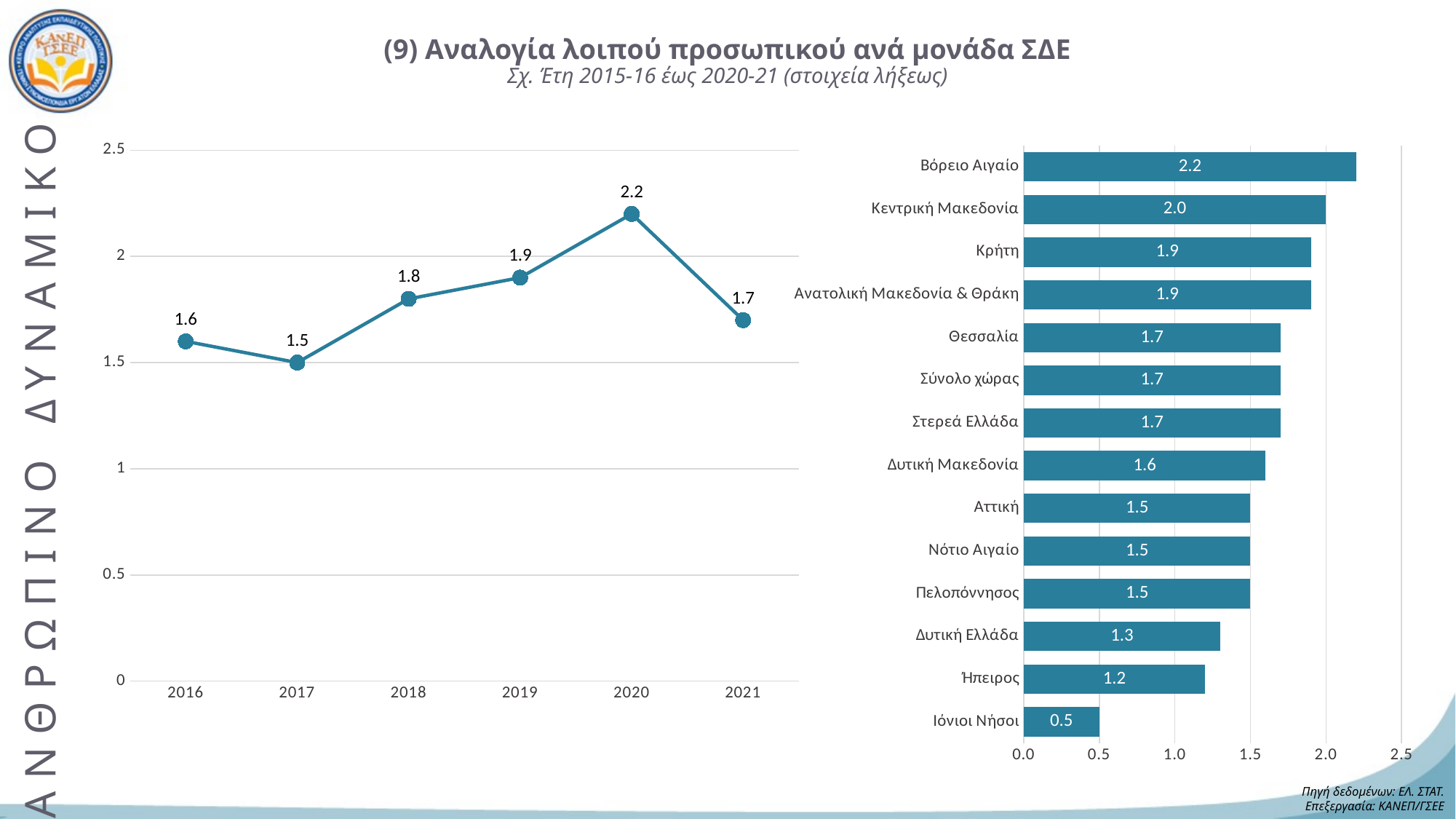
In the bar chart on the right, which is larger, the value for Κεντρική Μακεδονία or the value for Ήπειρος? Κεντρική Μακεδονία In the bar chart on the right, which region has the lowest value? Ιόνιοι Νήσοι In the line chart on the left, what is the value for 2020? 2.2 In the line chart on the left, what is the value for 2017? 1.5 In the line chart on the left, what is the difference between the values for 2020 and 2021? 0.5 In the bar chart on the right, what is the value for Σύνολο χώρας? 1.7 In the bar chart on the right, what is the value for Βόρειο Αιγαίο? 2.2 In the line chart on the left, which year has the lowest value? 2017 In the line chart on the left, does the value rise or fall from 2017 to 2020? rise What kind of chart is the chart on the right? bar chart In the line chart on the left, which year has the highest value? 2020 In the line chart on the left, how many years are plotted? 6